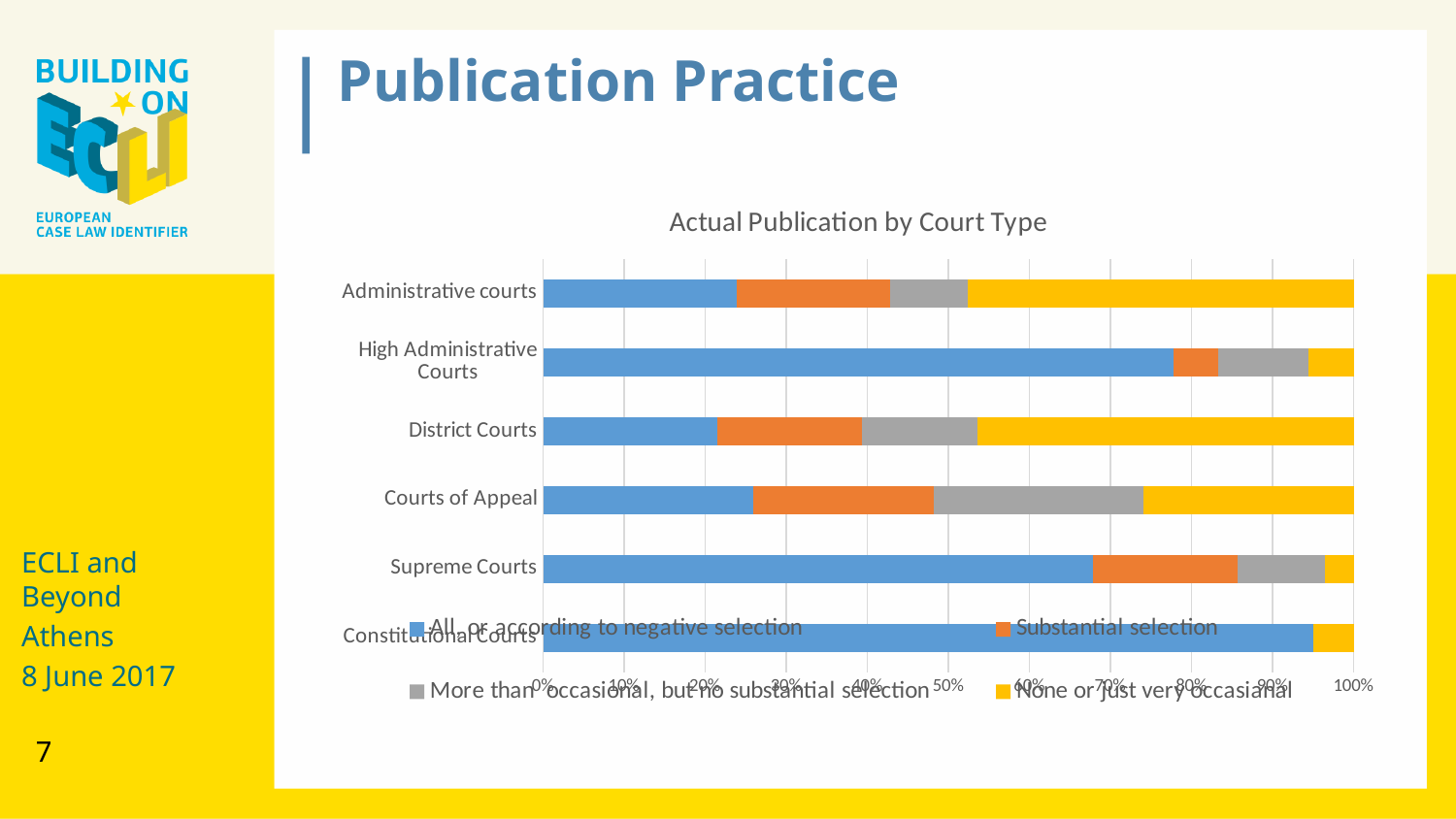
What is the title of the chart? Actual Publication by Court Type Is the 'All, or according to negative selection' share for Administrative courts greater or less than 30%? less What kind of chart is shown on the slide? Stacked bar chart Which court type has the largest share for 'All, or according to negative selection'? Constitutional Courts Which colour represents 'None or just very occasional' in the chart? Yellow Is the 'All, or according to negative selection' share for Supreme Courts greater or less than 60%? greater Is the 'All, or according to negative selection' share for Constitutional Courts greater or less than 90%? greater How many court types are shown on the chart? 6 How many series does the legend list? 4 Which has a larger 'All, or according to negative selection' share: Supreme Courts or Courts of Appeal? Supreme Courts